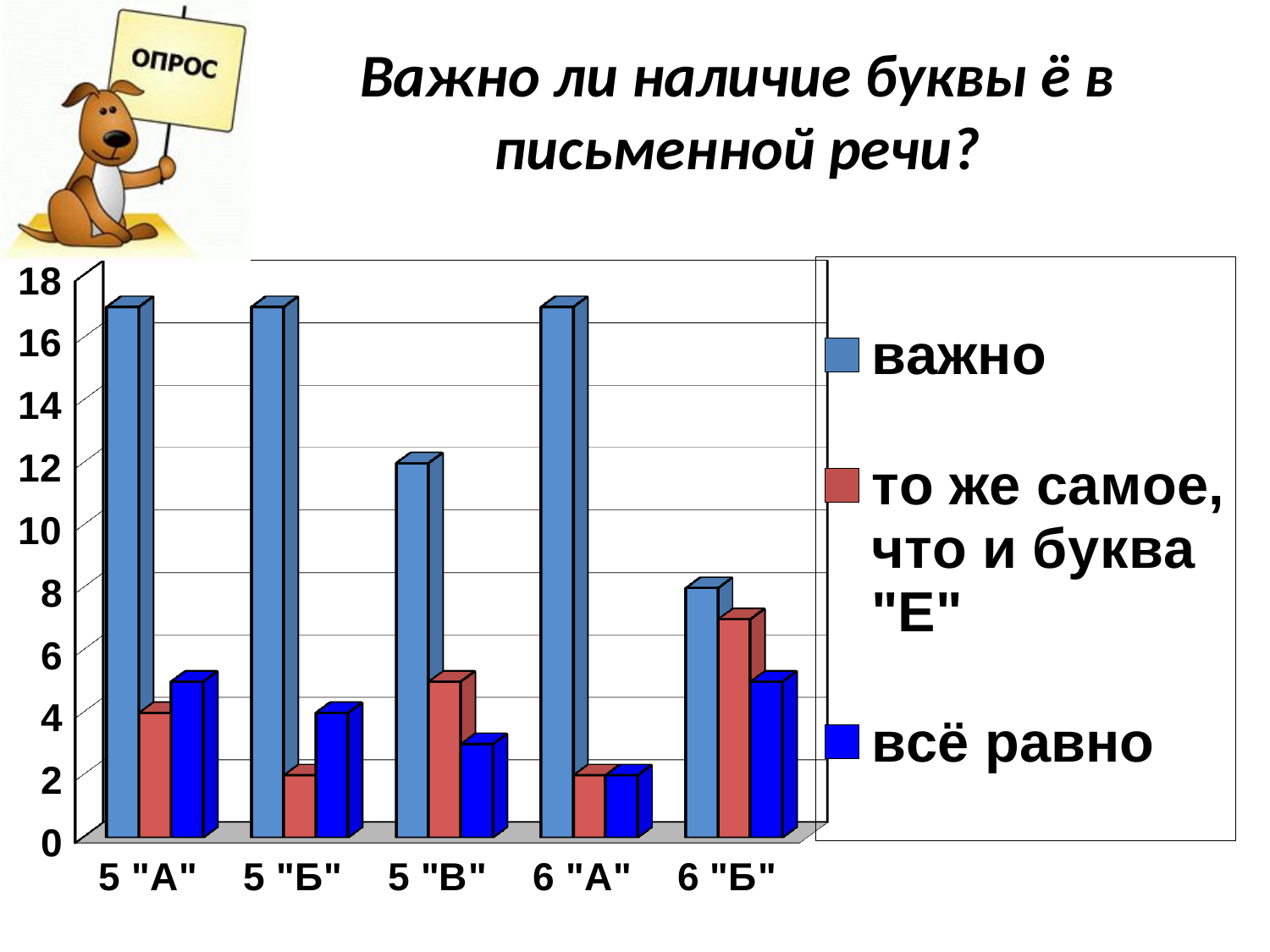
What colour represents the "всё равно" series in the chart? blue How many series does the chart legend list? 3 Is the value of "то же самое, что и буква "Е"" for 6 "Б" greater or less than 6? greater Is the value of "важно" for 5 "В" greater or less than 10? greater Is the value of "важно" for 6 "Б" greater or less than 10? less For 5 "В", which is larger: "важно" or "всё равно"? важно What kind of chart is shown on the slide? bar chart How many classes (categories) are shown on the x axis of the chart? 5 Which class has the highest value for "то же самое, что и буква "Е""? 6 "Б" Which class has the lowest value for "важно"? 6 "Б"